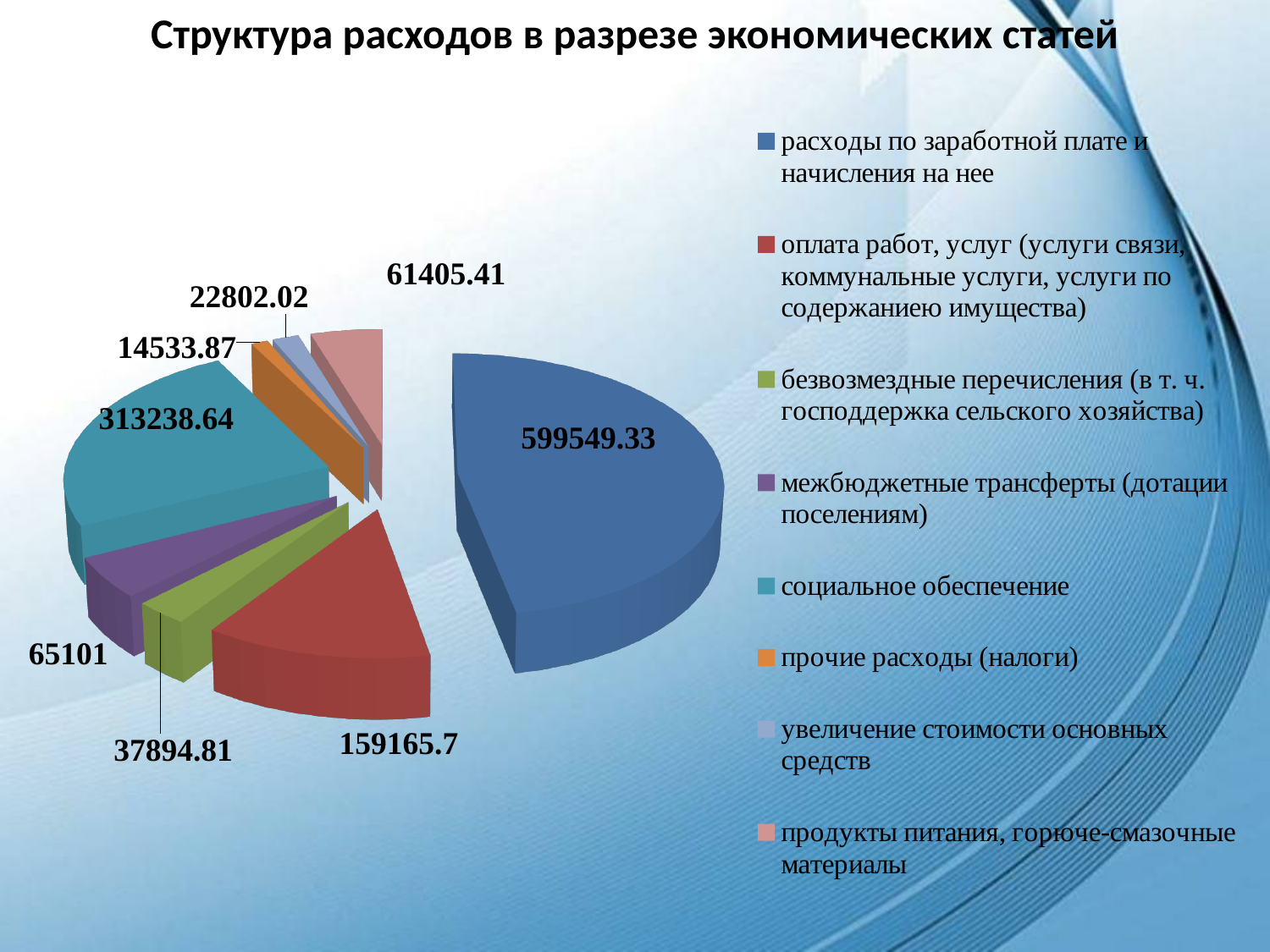
What is the value for "прочие расходы (налоги)"? 14533.87 What is the title of the slide's chart? Структура расходов в разрезе экономических статей Which category has the largest slice of the pie? расходы по заработной плате и начисления на нее What is the value for "оплата работ, услуг (услуги связи, коммунальные услуги, услуги по содержанию имущества)"? 159165.7 What type of chart is shown on the slide? pie chart What is the value for "межбюджетные трансферты (дотации поселениям)"? 65101 What is the difference between the values for "расходы по заработной плате и начисления на нее" and "социальное обеспечение"? 286310.69 What is the value for "расходы по заработной плате и начисления на нее"? 599549.33 Which is larger: the value for "безвозмездные перечисления (в т. ч. господдержка сельского хозяйства)" or the value for "продукты питания, горюче-смазочные материалы"? продукты питания, горюче-смазочные материалы Which category has the smallest slice of the pie? прочие расходы (налоги) How many slices does the pie chart have? 8 What is the value for "социальное обеспечение"? 313238.64